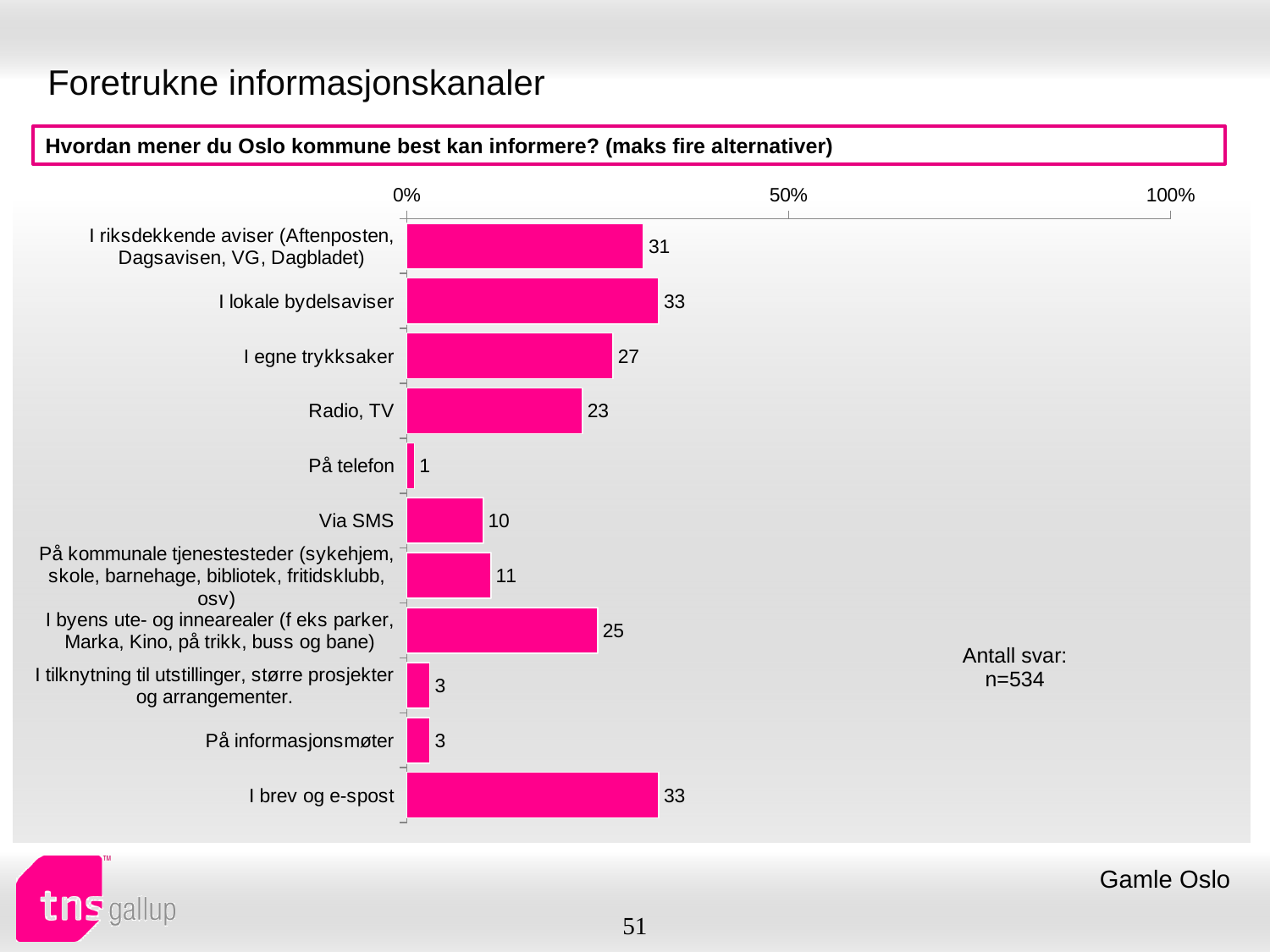
What value is shown for "Radio, TV"? 23 What is the difference between the values for "I lokale bydelsaviser" and "Radio, TV"? 10 Which category has the lowest value? På telefon Which is larger, the value for "I egne trykksaker" or the value for "I byens ute- og innearealer (f eks parker, Marka, Kino, på trikk, buss og bane)"? I egne trykksaker What value is shown for "I riksdekkende aviser (Aftenposten, Dagsavisen, VG, Dagbladet)"? 31 How many categories are shown in the chart? 11 What is the difference between the values for "På kommunale tjenestesteder (sykehjem, skole, barnehage, bibliotek, fritidsklubb, osv)" and "På informasjonsmøter"? 8 Is the value for "I brev og e-post" greater or less than 50%? less What is the number of responses (n) stated on the slide? n=534 What value is shown for "Via SMS"? 10 What value is shown for "I egne trykksaker"? 27 What kind of chart is shown on the slide? bar chart